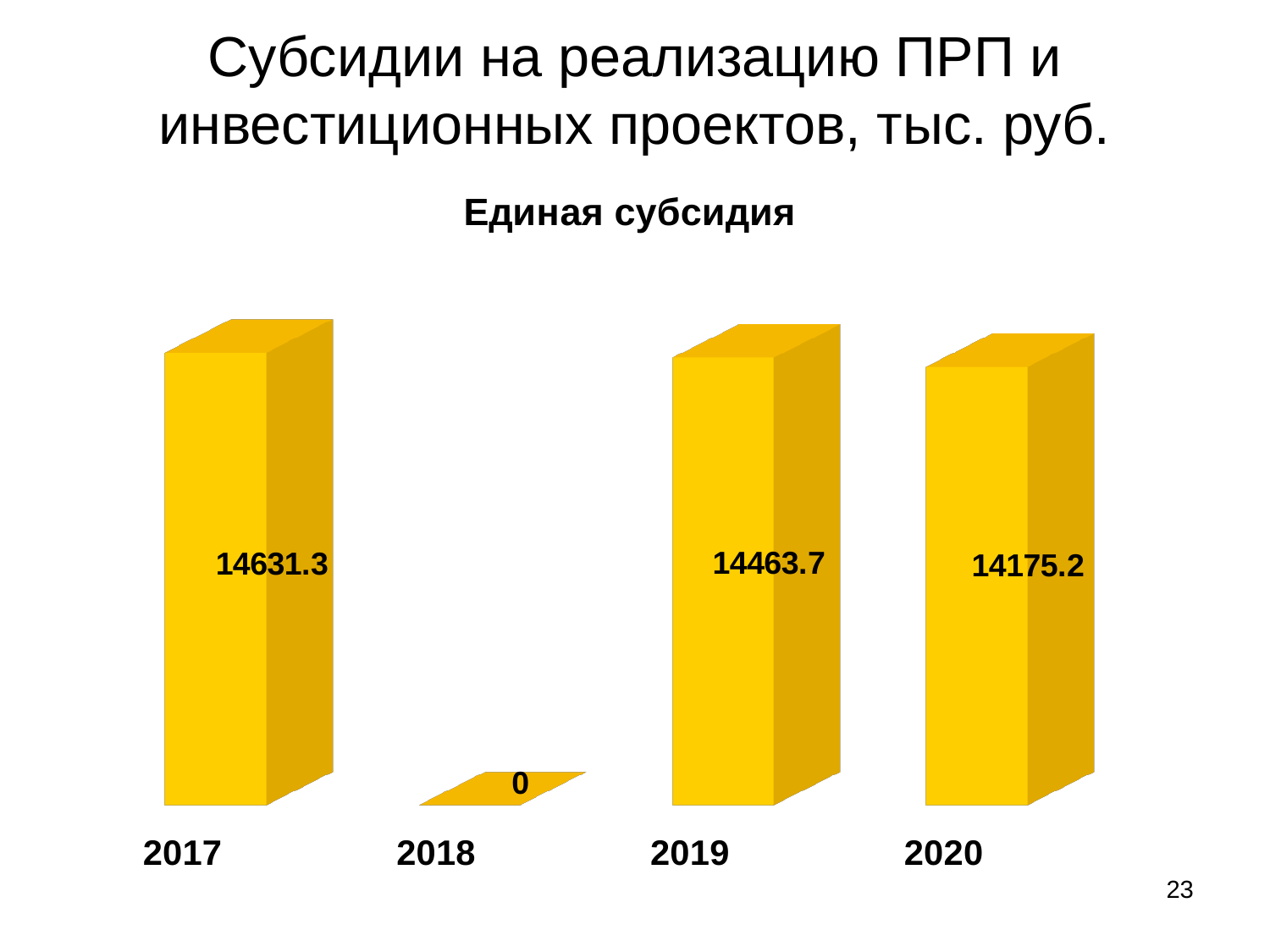
How many years are shown on the x axis? 4 What is the title of the chart? Единая субсидия Which is larger, the value for 2019 or the value for 2020? 2019 What is the value for 2020? 14175.2 What is the value for 2017? 14631.3 What is the value for 2019? 14463.7 What is the difference between the values for 2019 and 2020? 288.5 Which year has the highest value? 2017 What kind of chart is shown on the slide? bar chart What is the value for 2018? 0 What is the difference between the values for 2017 and 2019? 167.6 Which year has the lowest value? 2018